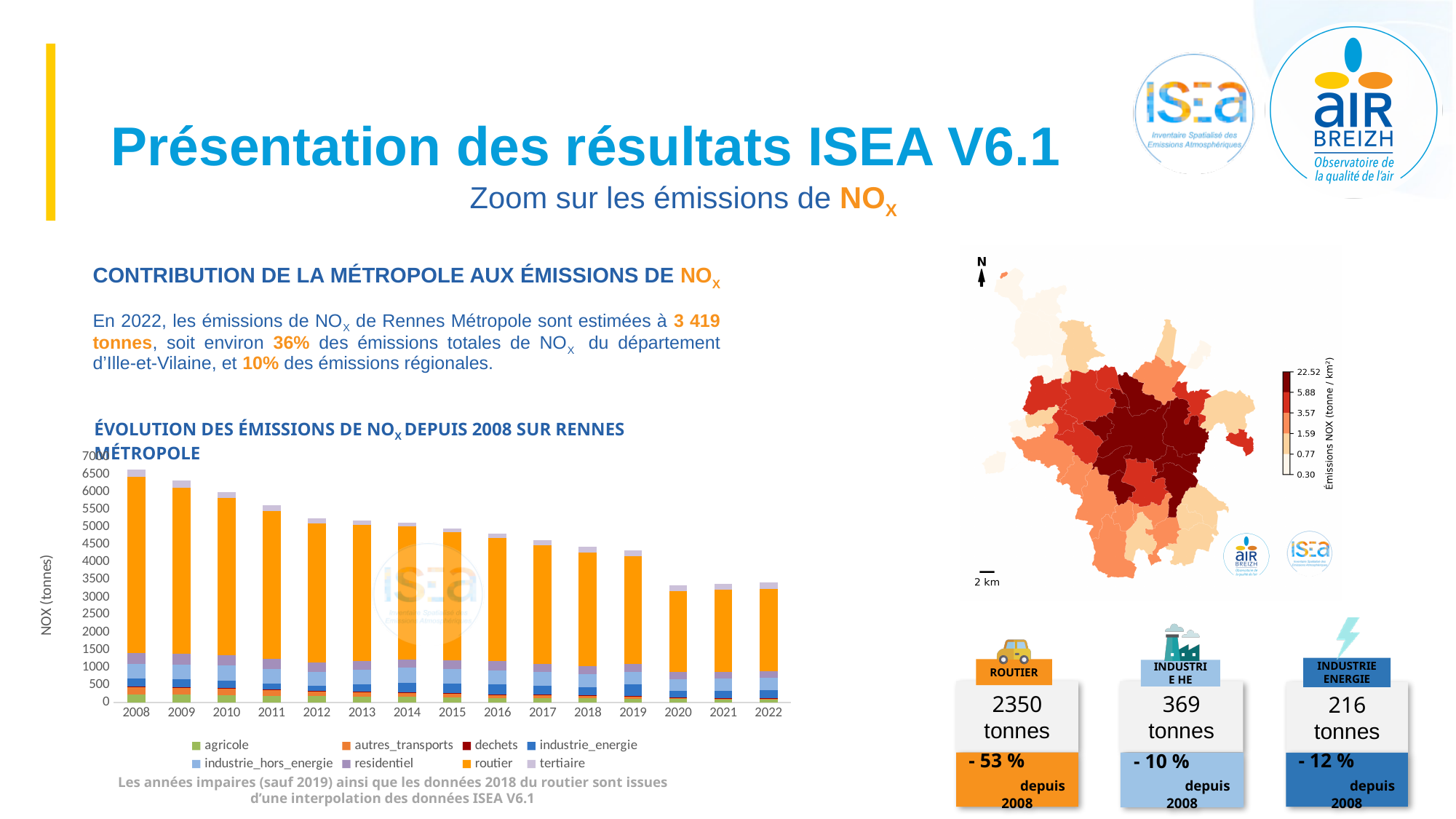
In the NOx emissions evolution chart, which year has the highest total emissions? 2008 What kind of chart is used to show the evolution of NOx emissions since 2008 on Rennes Métropole? stacked bar chart In the NOx emissions evolution chart, is the total for 2012 greater or less than 5000? greater How many series does the legend of the NOx emissions evolution chart list? 8 In the NOx emissions evolution chart, is the total for 2020 greater or less than 4000? less In the NOx emissions evolution chart, is the total for 2008 greater or less than 6000? greater In the NOx emissions evolution chart, which year has the larger total emissions, 2008 or 2022? 2008 How many years are shown on the x axis of the NOx emissions evolution chart? 15 Which series makes up the largest part of each bar in the NOx emissions evolution chart? routier In the NOx emissions evolution chart, do total emissions rise or fall from 2008 to 2022? fall What is the y-axis title of the NOx emissions evolution chart? NOX (tonnes)